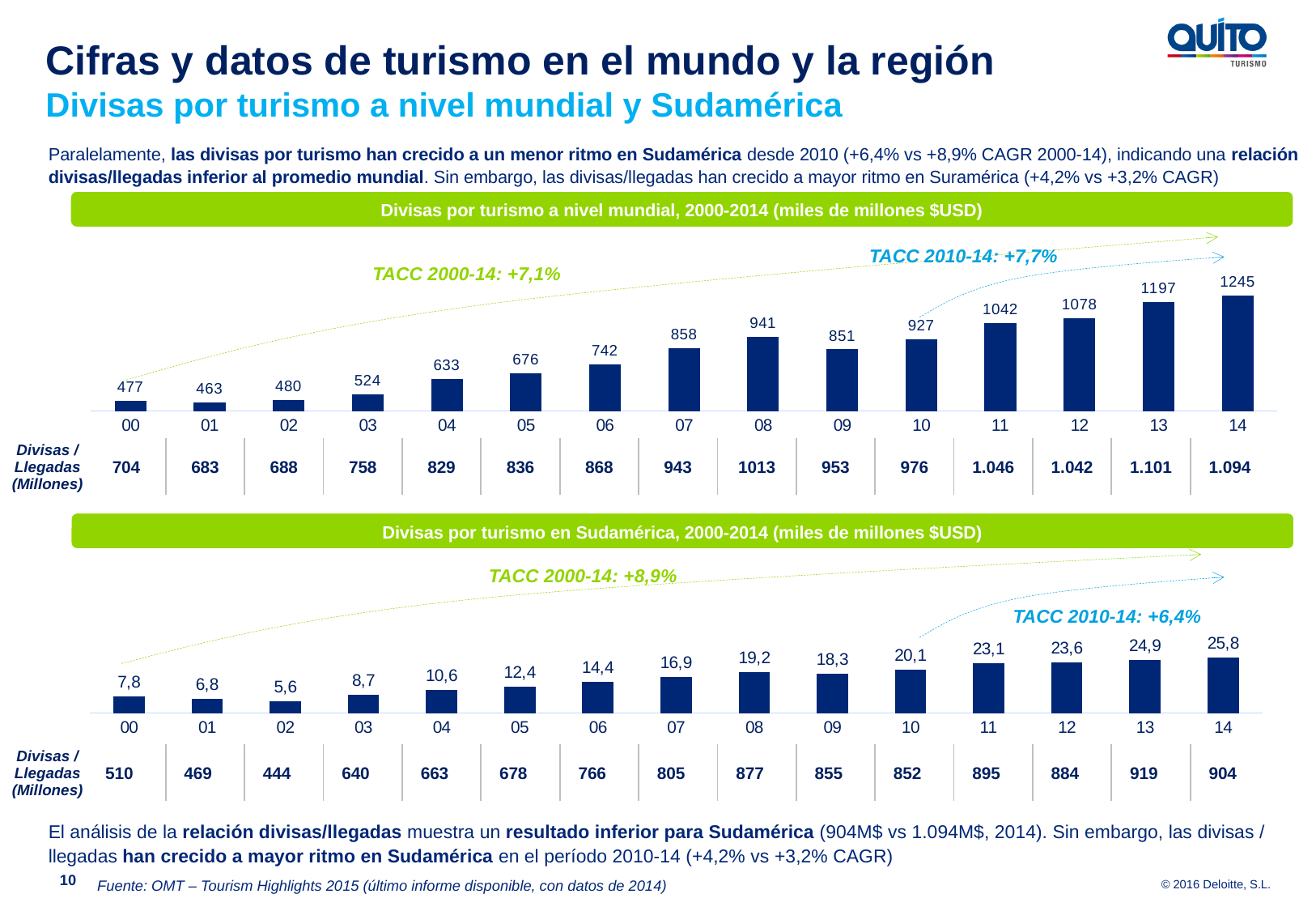
In the chart 'Divisas por turismo a nivel mundial, 2000-2014', what is the difference between the values for 14 and 13? 48 What kind of chart is 'Divisas por turismo en Sudamérica, 2000-2014'? bar chart In the chart 'Divisas por turismo a nivel mundial, 2000-2014', which year has the highest value? 14 In the chart 'Divisas por turismo a nivel mundial, 2000-2014', which year has the lowest value? 01 In the chart 'Divisas por turismo en Sudamérica, 2000-2014', which is larger, the value for 08 or the value for 09? 08 In the chart 'Divisas por turismo a nivel mundial, 2000-2014', how many years are plotted? 15 In the chart 'Divisas por turismo a nivel mundial, 2000-2014', which is larger, the value for 08 or the value for 09? 08 In the chart 'Divisas por turismo a nivel mundial, 2000-2014', what is the value for 08? 941 In the chart 'Divisas por turismo en Sudamérica, 2000-2014', what is the value for 10? 20,1 In the chart 'Divisas por turismo en Sudamérica, 2000-2014', which year has the lowest value? 02 In the chart 'Divisas por turismo en Sudamérica, 2000-2014', what TACC is shown for 2010-14? +6,4% In the chart 'Divisas por turismo en Sudamérica, 2000-2014', what is the difference between the values for 14 and 00? 18